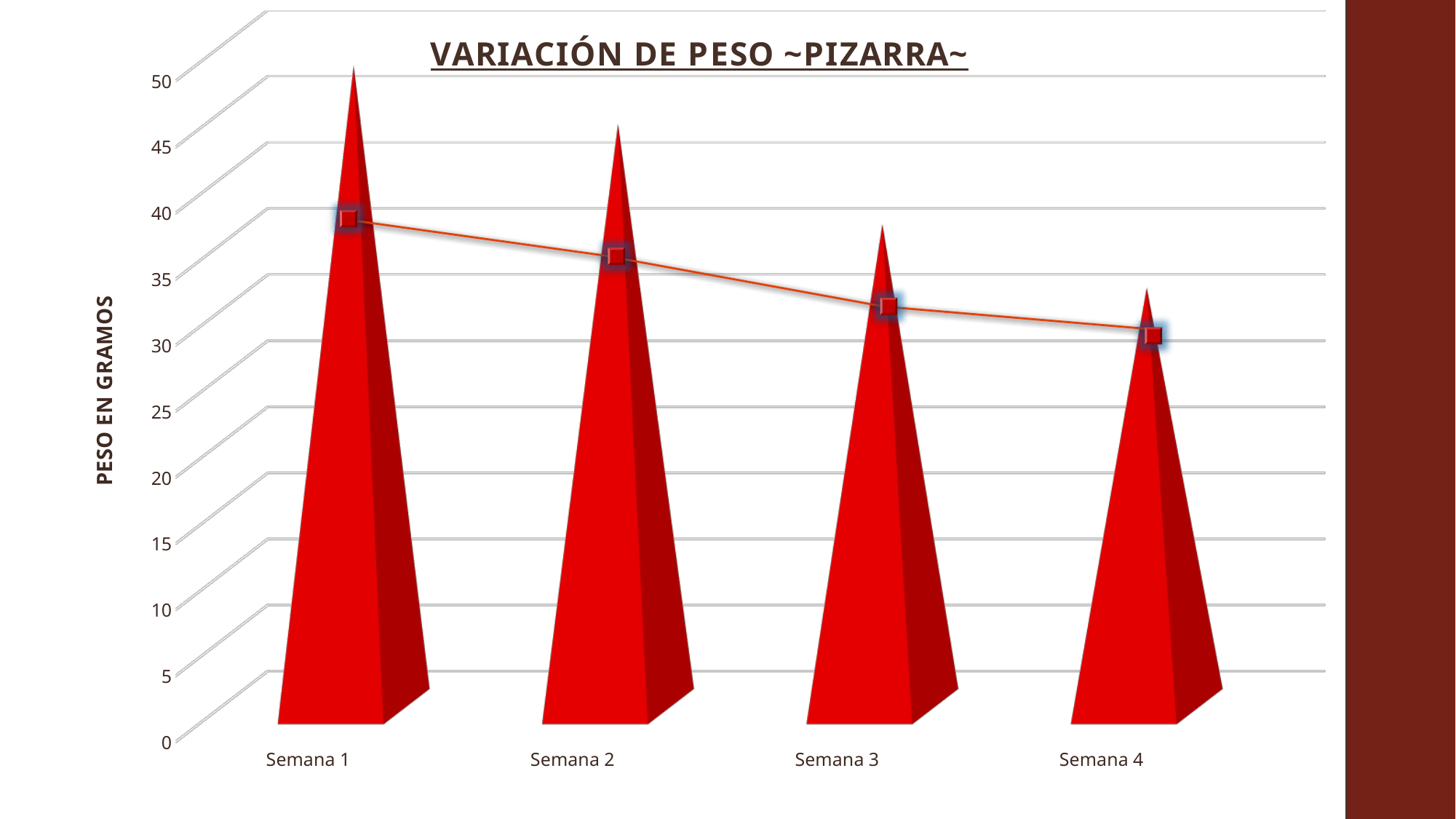
Is the value for Semana 3 greater or less than 45? less Which week has the highest value? Semana 1 Is the value for Semana 4 greater or less than 40? less Is the value for Semana 1 greater or less than 30? greater What is the title of the chart? VARIACIÓN DE PESO ~PIZARRA~ Which week has the lowest value? Semana 4 How many categories (weeks) are shown on the x axis? 4 Which is larger, the value for Semana 1 or the value for Semana 4? Semana 1 Do the values rise or fall from Semana 1 to Semana 4? fall Which is larger, the value for Semana 2 or the value for Semana 3? Semana 2 What is the label on the vertical axis of the chart? PESO EN GRAMOS